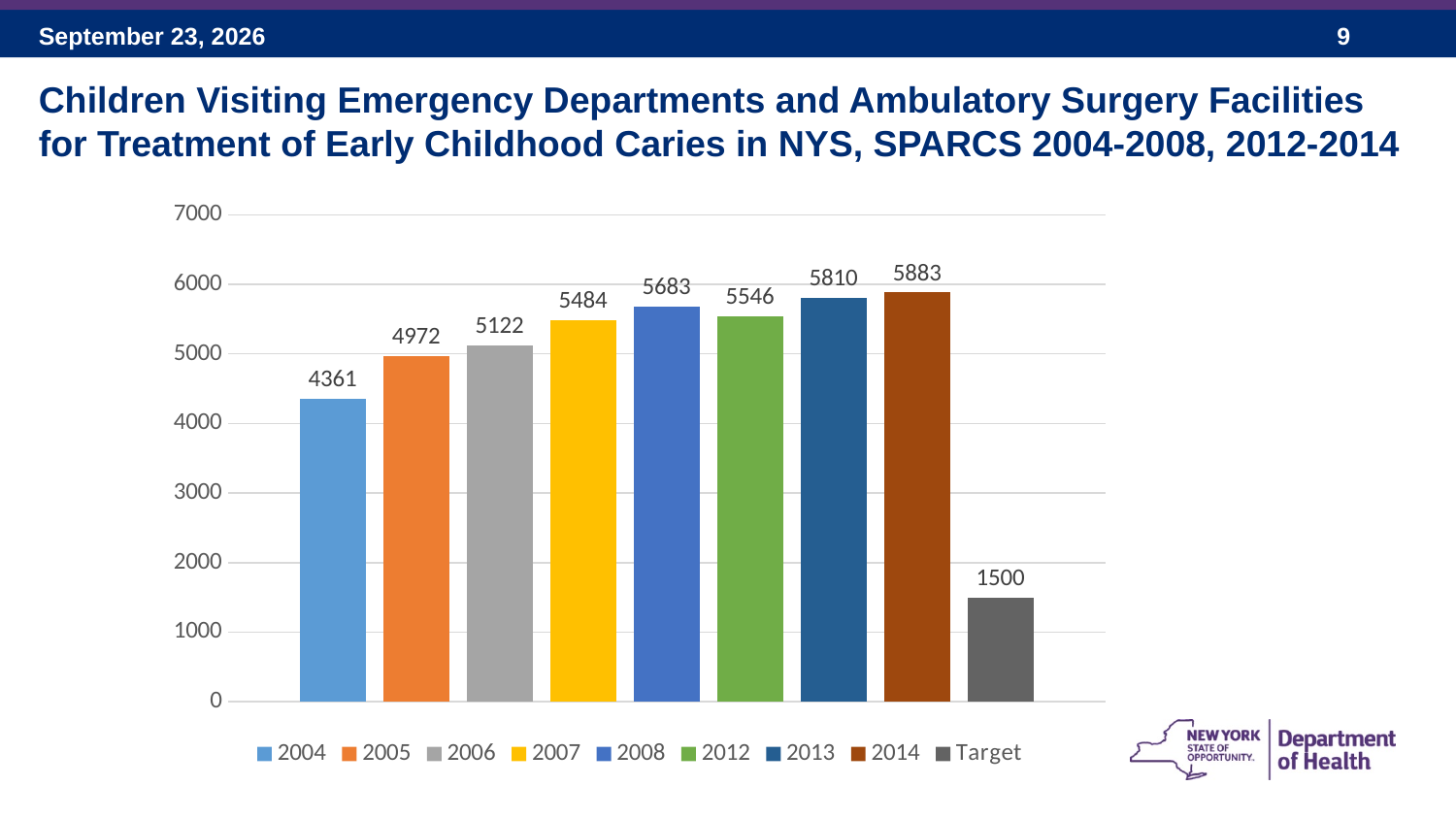
How many entries does the legend list? 9 Do the values rise or fall from 2004 to 2008? rise What is the difference between the values for 2014 and 2004? 1522 How many bars are plotted in the chart? 9 What is the value for Target? 1500 Which category has the highest value? 2014 What kind of chart is shown on the slide? bar chart Which category has the lowest value? Target What is the value for 2012? 5546 Is the value for 2007 greater or less than 5000? greater What is the value for 2004? 4361 Which is larger, the value for 2008 or the value for 2012? 2008